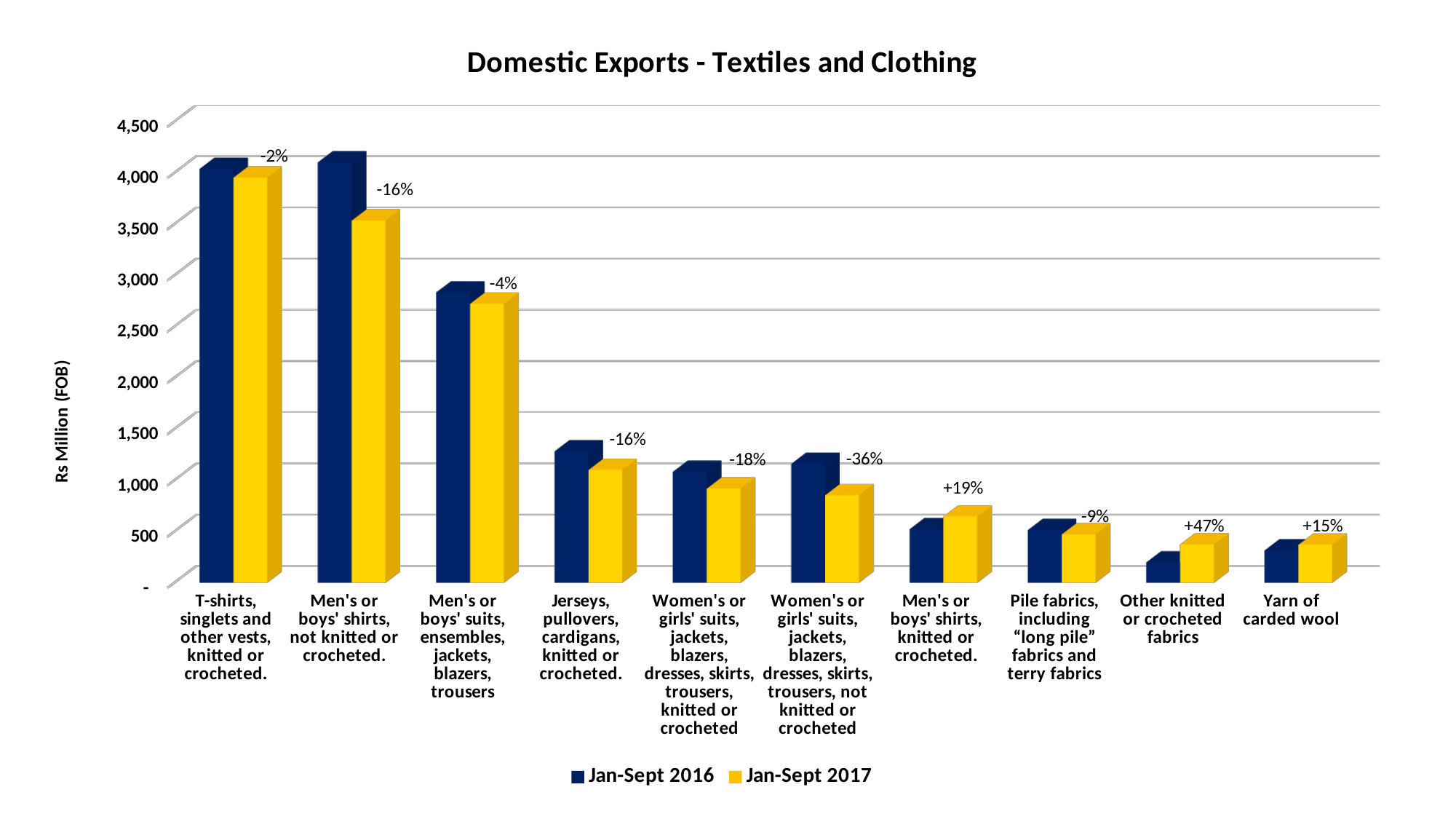
What percentage change is labelled for Pile fabrics, including "long pile" fabrics and terry fabrics? -9% What percentage change is labelled for Women's or girls' suits, jackets, blazers, dresses, skirts, trousers, not knitted or crocheted? -36% Is the Jan-Sept 2017 value for Men's or boys' shirts, not knitted or crocheted greater or less than 4,000? less What colour represents the Jan-Sept 2017 series? Yellow What kind of chart is shown on the slide? Bar chart How many series does the legend list? 2 How many product categories are shown on the x axis? 10 Which category has the lowest Jan-Sept 2016 value? Other knitted or crocheted fabrics Is the Jan-Sept 2016 value for Jerseys, pullovers, cardigans, knitted or crocheted greater or less than 1,000? greater What percentage change is labelled for Other knitted or crocheted fabrics? +47% Which category has the highest Jan-Sept 2017 value? T-shirts, singlets and other vests, knitted or crocheted. For Men's or boys' shirts, knitted or crocheted, which is larger: the Jan-Sept 2016 value or the Jan-Sept 2017 value? Jan-Sept 2017